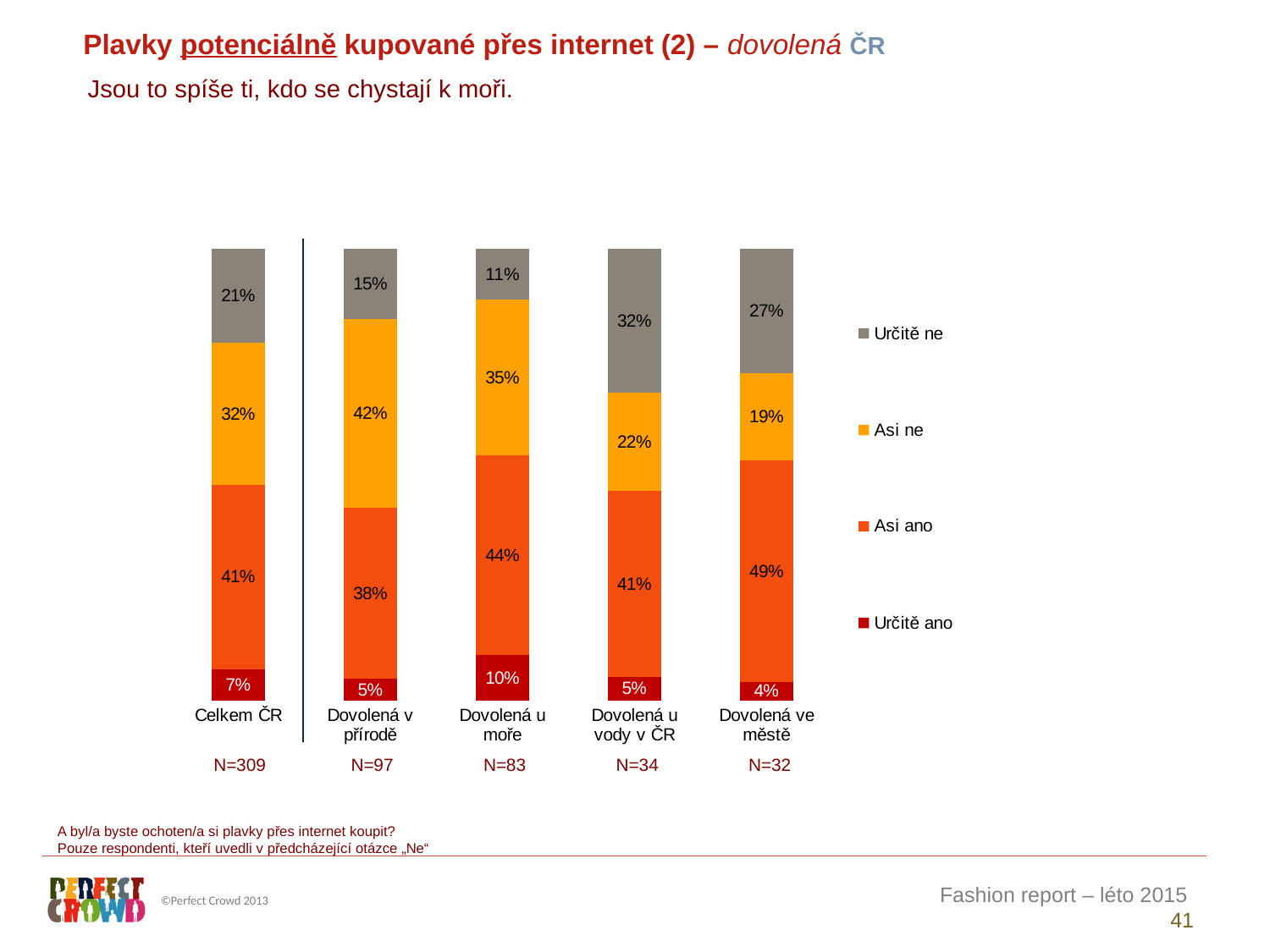
How many categories are shown on the x axis of the chart? 5 What is the difference between the "Určitě ne" values for "Dovolená u vody v ČR" and "Dovolená u moře"? 21 percentage points What is the value for "Asi ne" in the "Dovolená v přírodě" bar? 42% What is the value for "Určitě ano" in the "Dovolená u moře" bar? 10% What is the value for "Určitě ne" in the "Dovolená ve městě" bar? 27% How many series does the legend list? 4 What is the total of the stacked bar for "Dovolená u moře"? 100% Which category has the highest value for "Určitě ne"? Dovolená u vody v ČR What kind of chart is shown on the slide? Stacked bar chart Which category has the lowest value for "Určitě ano"? Dovolená ve městě Which has the larger "Asi ne" value, "Celkem ČR" or "Dovolená u moře"? Dovolená u moře Which category has the highest value for "Asi ano"? Dovolená ve městě